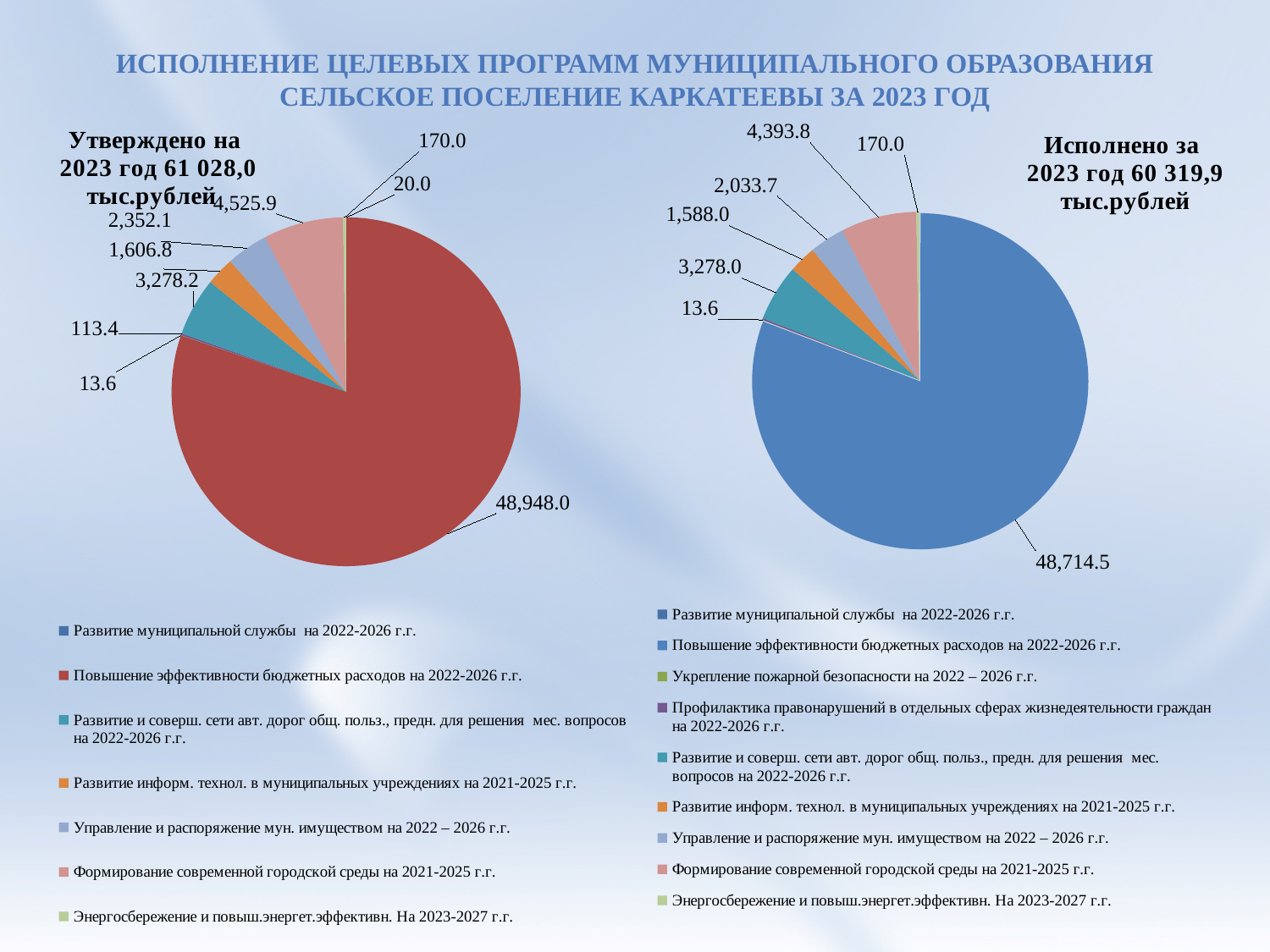
What type of chart is used on this slide? Pie chart In the left pie chart (Утверждено на 2023 год), what is the value of the largest slice? 48,948.0 What is the difference between the largest slice of the left chart (48,948.0) and the largest slice of the right chart (48,714.5)? 233.5 How many entries does the legend of the right pie chart list? 9 According to the heading of the right chart, what total amount was executed for 2023? 60 319,9 тыс.рублей How many entries does the legend of the left pie chart list? 7 In the left pie chart, what is the value of the teal slice for 'Развитие и соверш. сети авт. дорог общ. польз.'? 3,278.2 Which is larger: the largest slice of the left chart (48,948.0) or the largest slice of the right chart (48,714.5)? The left chart (48,948.0) In the right pie chart (Исполнено за 2023 год), what is the value of the largest slice? 48,714.5 How many data labels are shown on the left pie chart? 9 In the left pie chart (Утверждено на 2023 год), what is the smallest labelled value? 13.6 In the right pie chart, what is the value of the pink slice for 'Формирование современной городской среды на 2021-2025 г.г.'? 4,393.8